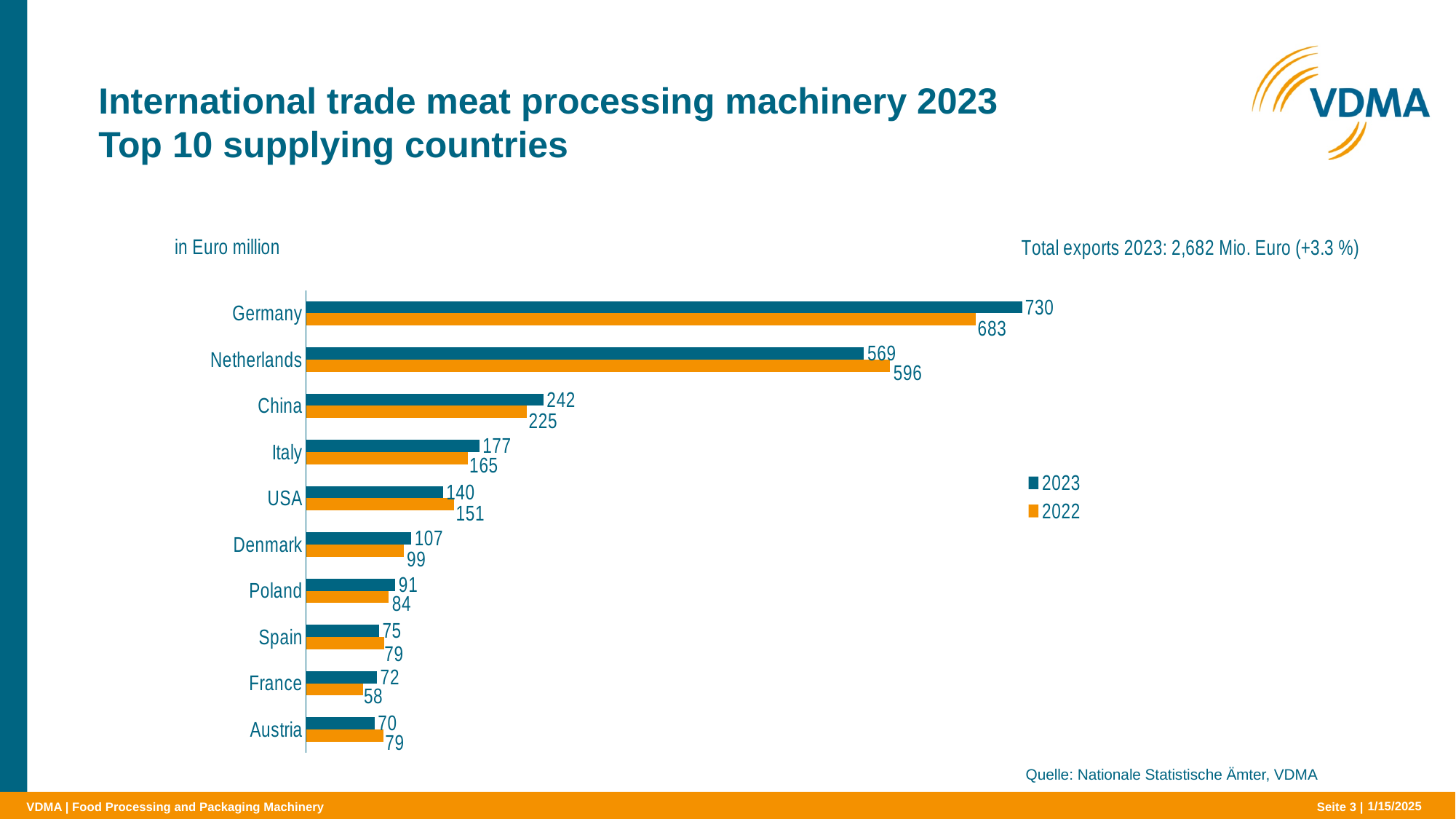
Which country has the highest value in 2023? Germany How many countries are shown in the chart? 10 Which is larger for the USA: the 2023 value or the 2022 value? 2022 What was the value for the Netherlands in 2022? 596 What kind of chart is shown on the slide? Bar chart What is the difference between Germany's 2023 and 2022 values? 47 How many series does the legend list? 2 What was the value for France in 2022? 58 Which country has the lowest value in 2023? Austria What was the value for Germany in 2023? 730 What is the difference between the Netherlands' 2022 and 2023 values? 27 Which is larger: China's 2023 value or Italy's 2023 value? China's 2023 value